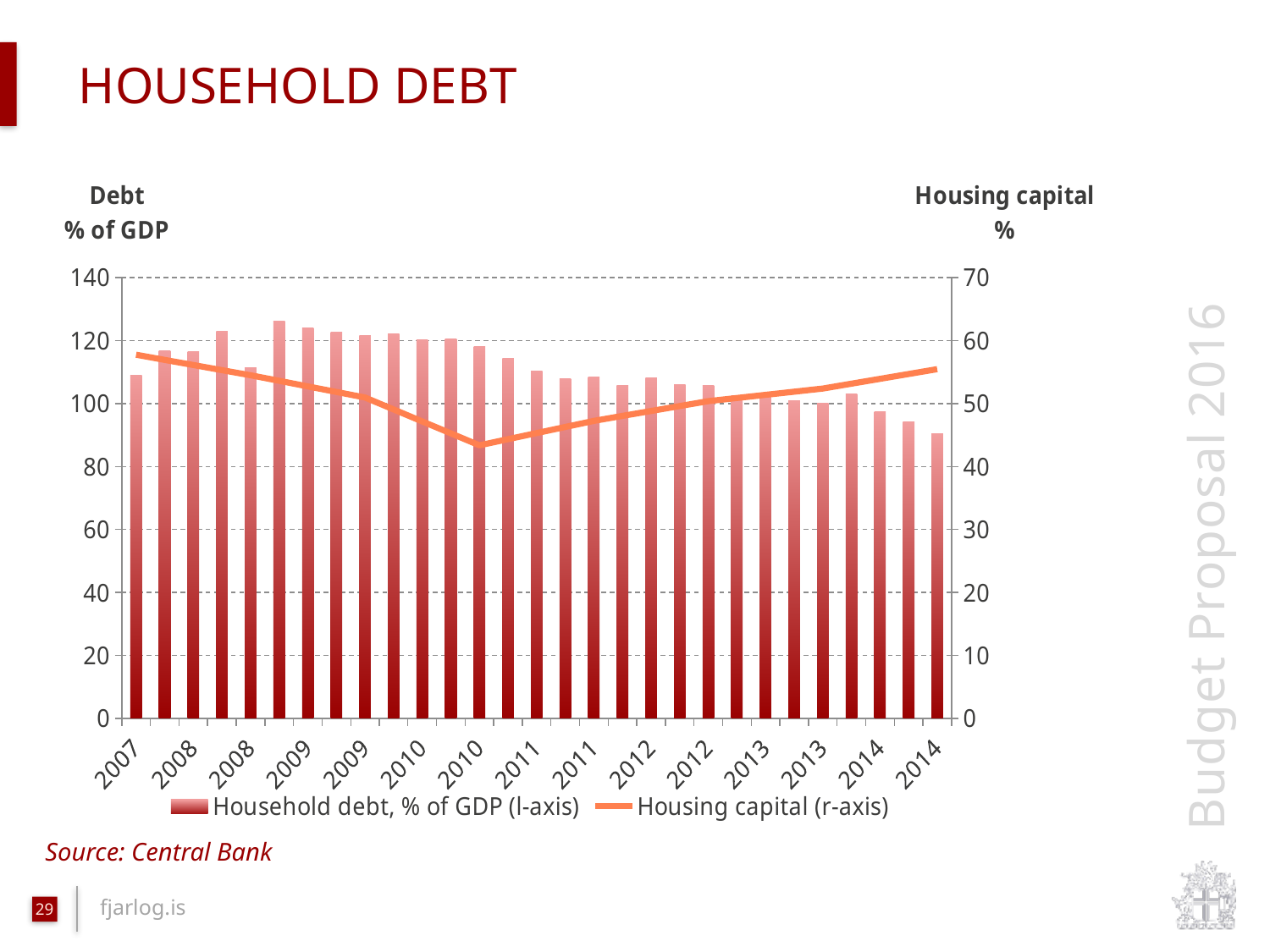
How many series does the legend list? 2 What is the title of the chart's left axis? Debt % of GDP In which year is household debt as % of GDP at its lowest? 2014 Is the housing capital value at 2007 greater or less than 50%? greater What kind of chart is shown on the slide? A combined bar and line chart In which year does the housing capital line reach its lowest point? 2010 Is the lowest housing capital value, around 2010, greater or less than 50%? less Does household debt as % of GDP rise or fall from 2010 to 2014? fall Which series is plotted as a line on the right axis? Housing capital (r-axis) Is the household debt value for 2007 greater or less than 100% of GDP? greater In which year does household debt as % of GDP reach its highest bar? 2009